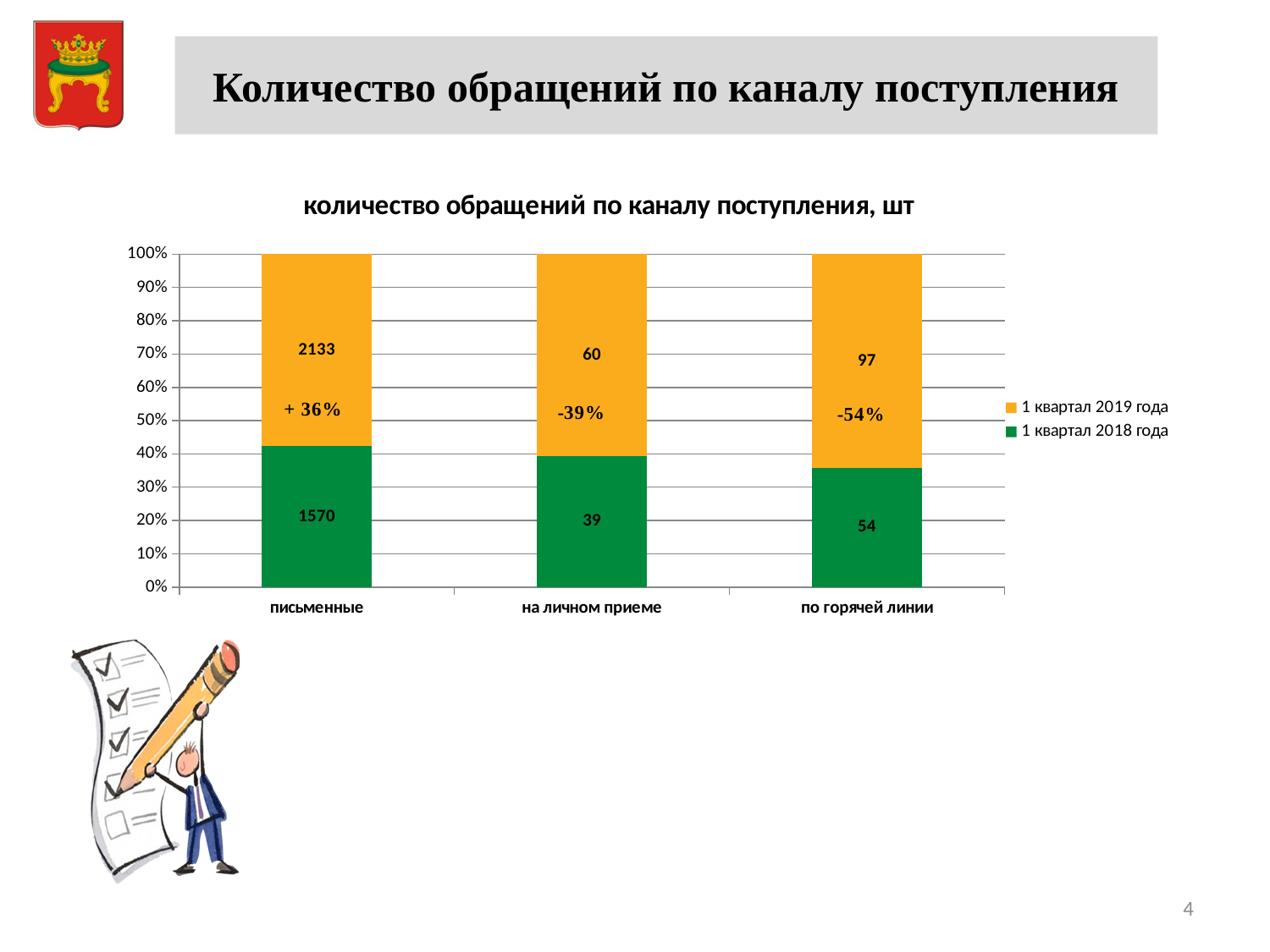
Which category has the highest value for 1 квартал 2019 года? письменные Which is larger for 1 квартал 2019 года: на личном приеме or по горячей линии? по горячей линии What is the difference between the 1 квартал 2019 года and 1 квартал 2018 года values for по горячей линии? 43 What is the value for на личном приеме in 1 квартал 2019 года? 60 What is the value for письменные in 1 квартал 2018 года? 1570 How many series does the legend list? 2 What is the difference between the 1 квартал 2019 года and 1 квартал 2018 года values for письменные? 563 How many categories are shown on the x axis? 3 What is the value for по горячей линии in 1 квартал 2018 года? 54 Which category has the lowest value for 1 квартал 2018 года? на личном приеме What is the value for письменные in 1 квартал 2019 года? 2133 What kind of chart is shown on the slide? stacked bar chart